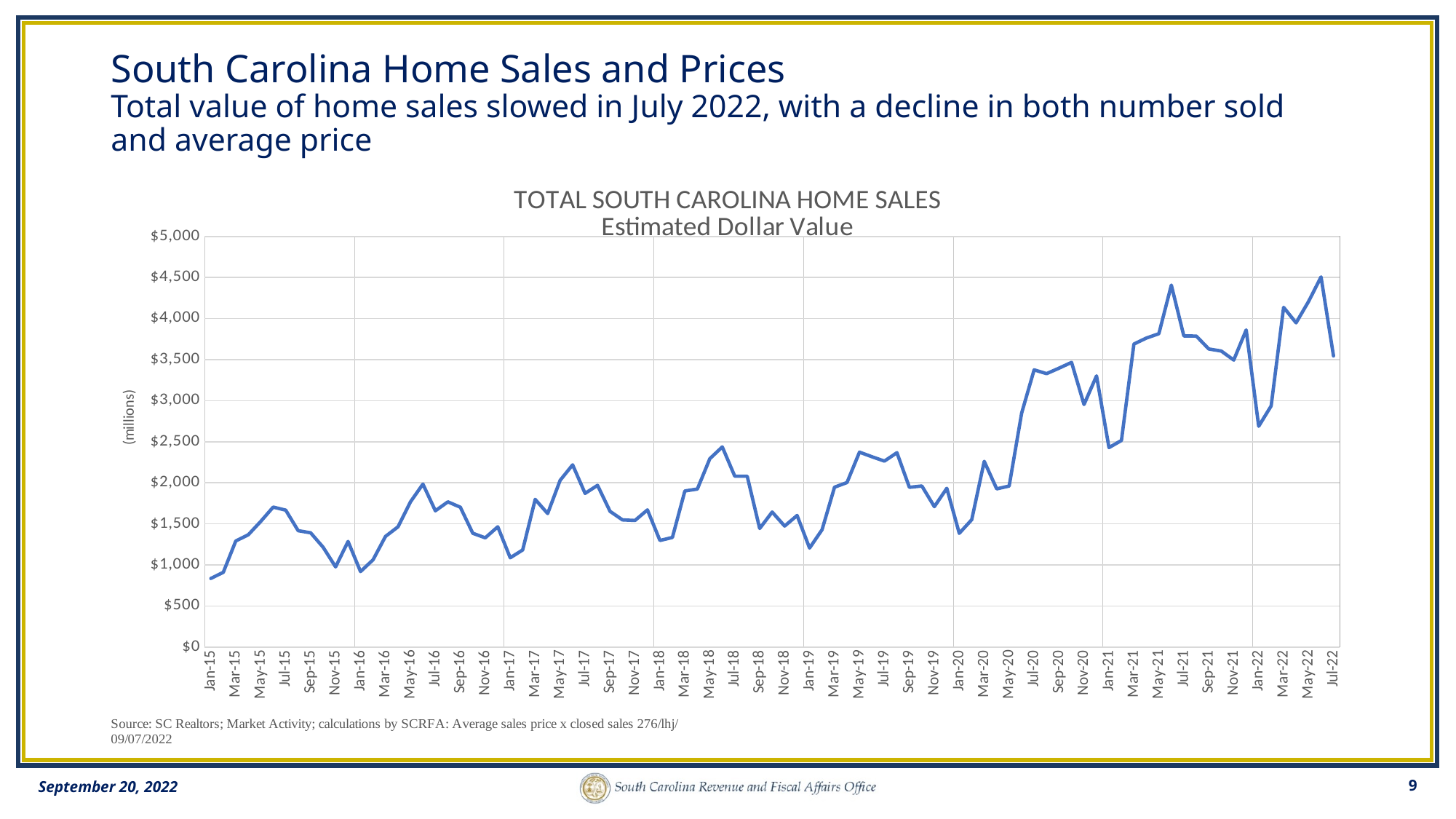
Is the value for Jul-22 greater or less than $3,000? greater Is the value for Jan-20 greater or less than $1,500? less Which is larger, the value for Jul-20 or the value for Jul-19? Jul-20 What unit is shown on the vertical axis label of the chart? (millions) Overall, do the values rise or fall from Jan-15 to Jul-22? rise Which is larger, the value for Jan-15 or the value for Jul-22? Jul-22 How many data series are plotted on the chart? 1 Is the value for Jul-20 greater or less than $3,000? greater What kind of chart is shown on the slide? line chart What is the title of the chart? TOTAL SOUTH CAROLINA HOME SALES Estimated Dollar Value